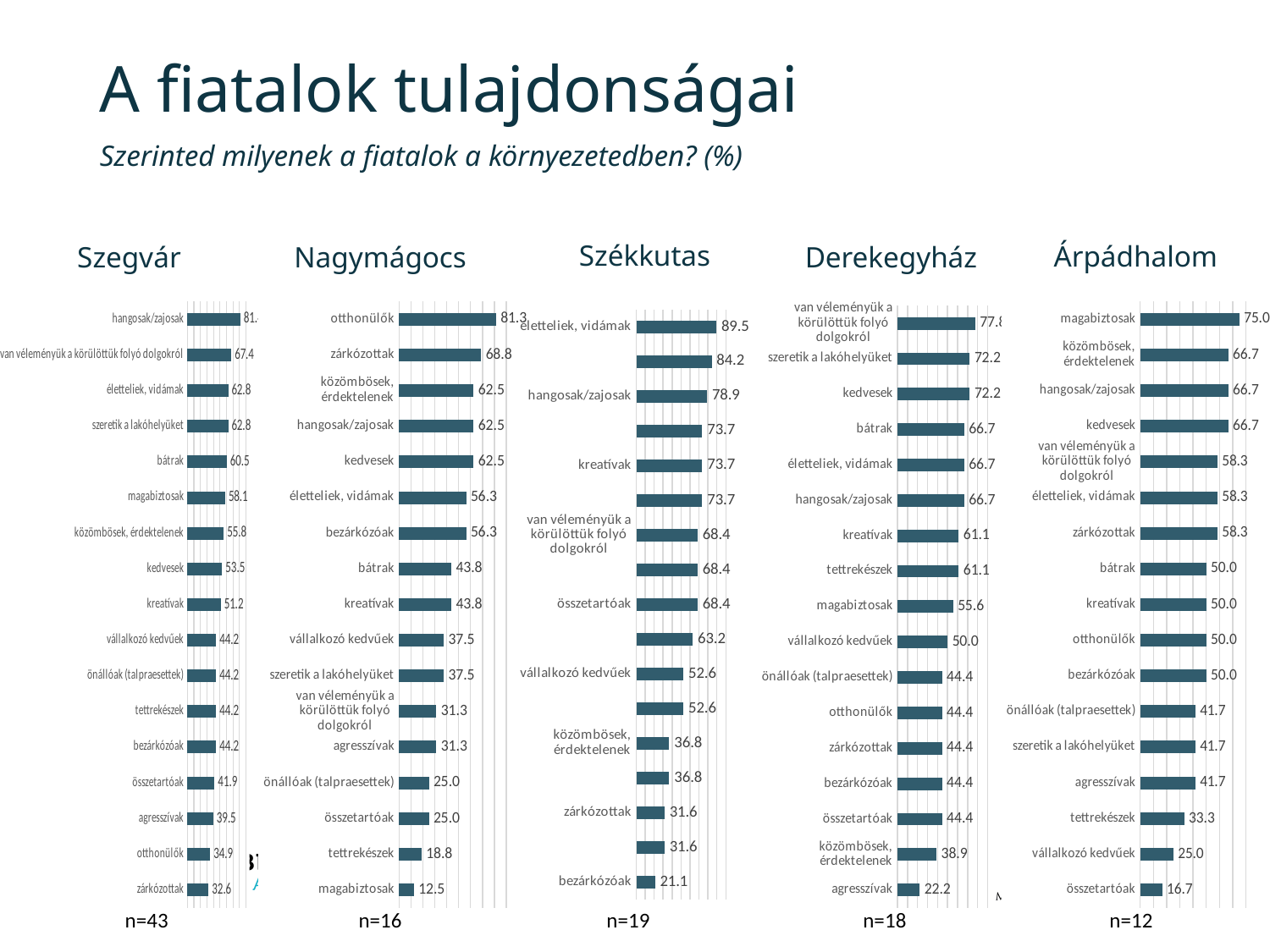
In the Nagymágocs chart, which category has the lowest value? magabiztosak In the Derekegyház chart, what is the difference between szeretik a lakóhelyüket and közömbösek, érdektelenek? 33.3 In the Szegvár chart, what is the value for zárkózottak? 32.6 In the Árpádhalom chart, which category has the highest value? magabiztosak In the Nagymágocs chart, which is larger: zárkózottak or kedvesek? zárkózottak In the Nagymágocs chart, what is the value for otthonülők? 81.3 In the Székkutas chart, what is the value for életteliek, vidámak? 89.5 How many bar charts are shown on the slide? 5 In the Derekegyház chart, what is the value for agresszívak? 22.2 What type of chart is used for Szegvár? bar chart In the Árpádhalom chart, what is the value for összetartóak? 16.7 In the Székkutas chart, which category has the lowest value? bezárkózóak